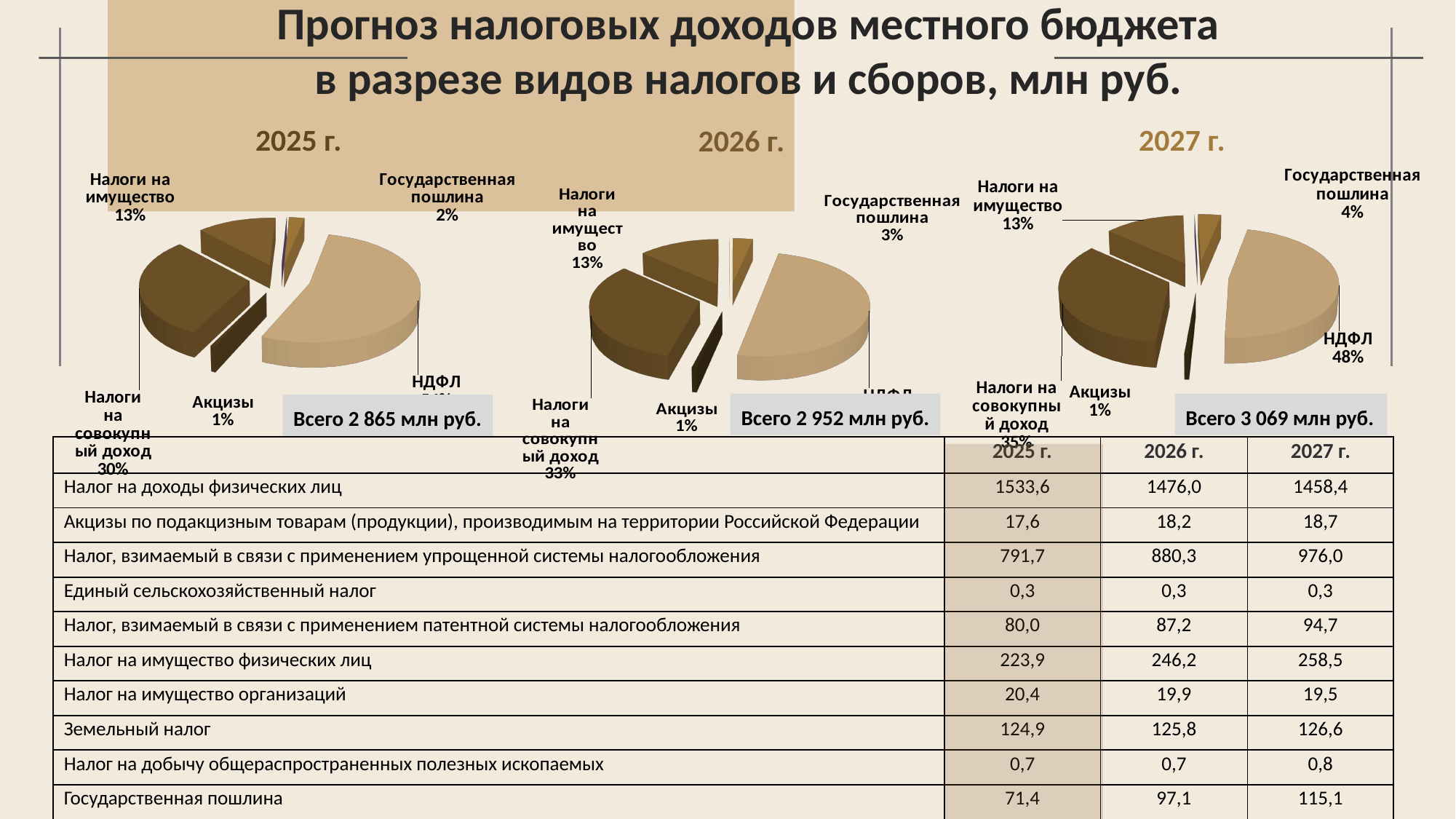
In the 2027 г. pie chart, which category has the largest share? НДФЛ How many slices does the 2025 г. pie chart have? 6 In the 2025 г. pie chart, what share does Налоги на совокупный доход have? 30% In the 2027 г. pie chart, what is the difference in percentage points between Налоги на совокупный доход and Налоги на имущество? 22 percentage points In the 2027 г. pie chart, what share does НДФЛ have? 48% In the 2027 г. pie chart, what share does Налоги на имущество have? 13% How many pie charts are shown on the slide? 3 What kind of chart is used for the 2025 г. data? Pie chart What total is shown below the 2026 г. pie chart? Всего 2 952 млн руб. In the 2026 г. pie chart, what share does Государственная пошлина have? 3% In the 2026 г. pie chart, which is larger: Налоги на совокупный доход or Налоги на имущество? Налоги на совокупный доход